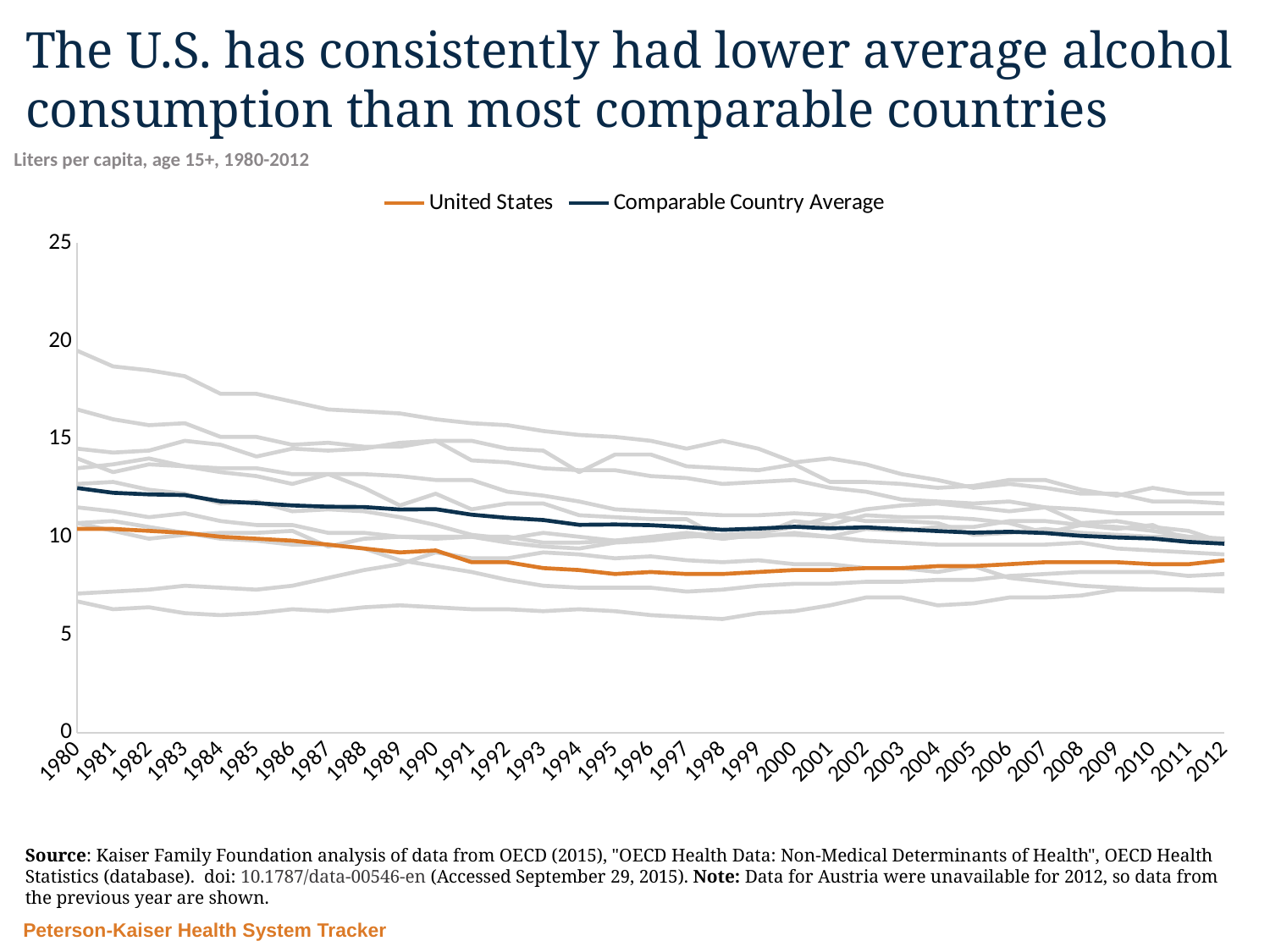
Is the value for the Comparable Country Average in 1980 greater or less than 10? greater In 2012, which is higher: the United States or the Comparable Country Average? Comparable Country Average In 1980, which is higher: the United States or the Comparable Country Average? Comparable Country Average How many years are labeled along the x axis? 33 Does the Comparable Country Average line rise or fall overall from 1980 to 2012? fall How many series does the legend list? 2 What unit does the subtitle say the chart measures? Liters per capita, age 15+ Is the value for the Comparable Country Average in 1990 greater or less than 10? greater Is the value for the United States in 1998 greater or less than 10? less What kind of chart is shown on the slide? line chart